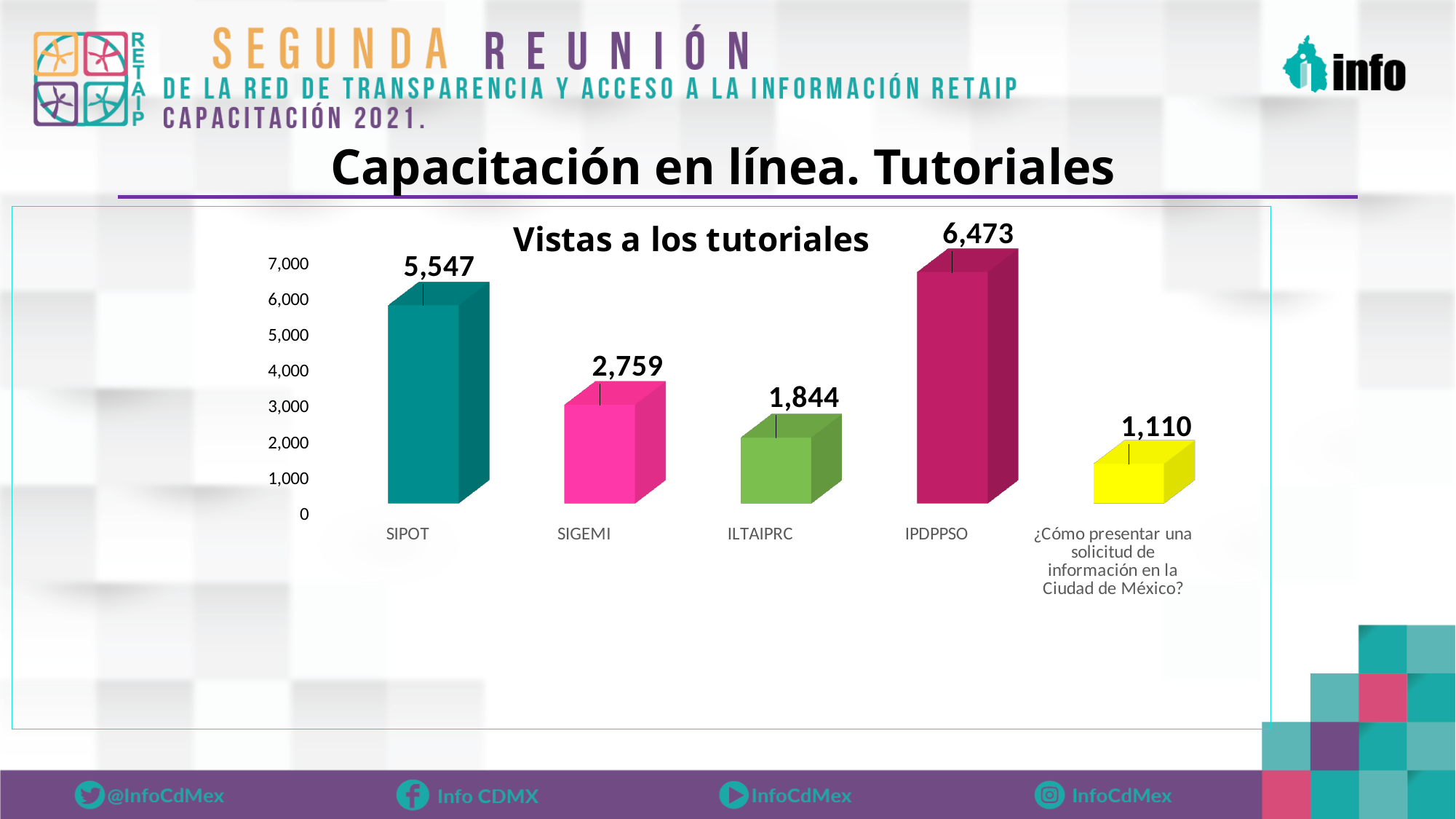
What is the value for the tutorial '¿Cómo presentar una solicitud de información en la Ciudad de México?'? 1,110 What is the difference between the views for IPDPPSO and SIPOT? 926 What is the value for IPDPPSO in the 'Vistas a los tutoriales' chart? 6,473 How many categories are shown in the 'Vistas a los tutoriales' chart? 5 Which has more views, SIPOT or SIGEMI? SIPOT Which category has the lowest number of views in the 'Vistas a los tutoriales' chart? ¿Cómo presentar una solicitud de información en la Ciudad de México? What is the value for ILTAIPRC in the 'Vistas a los tutoriales' chart? 1,844 What is the difference between the views for SIGEMI and ILTAIPRC? 915 What is the value for SIGEMI in the 'Vistas a los tutoriales' chart? 2,759 What is the value for SIPOT in the 'Vistas a los tutoriales' chart? 5,547 What kind of chart is 'Vistas a los tutoriales'? Bar chart Which category has the highest number of views in the 'Vistas a los tutoriales' chart? IPDPPSO